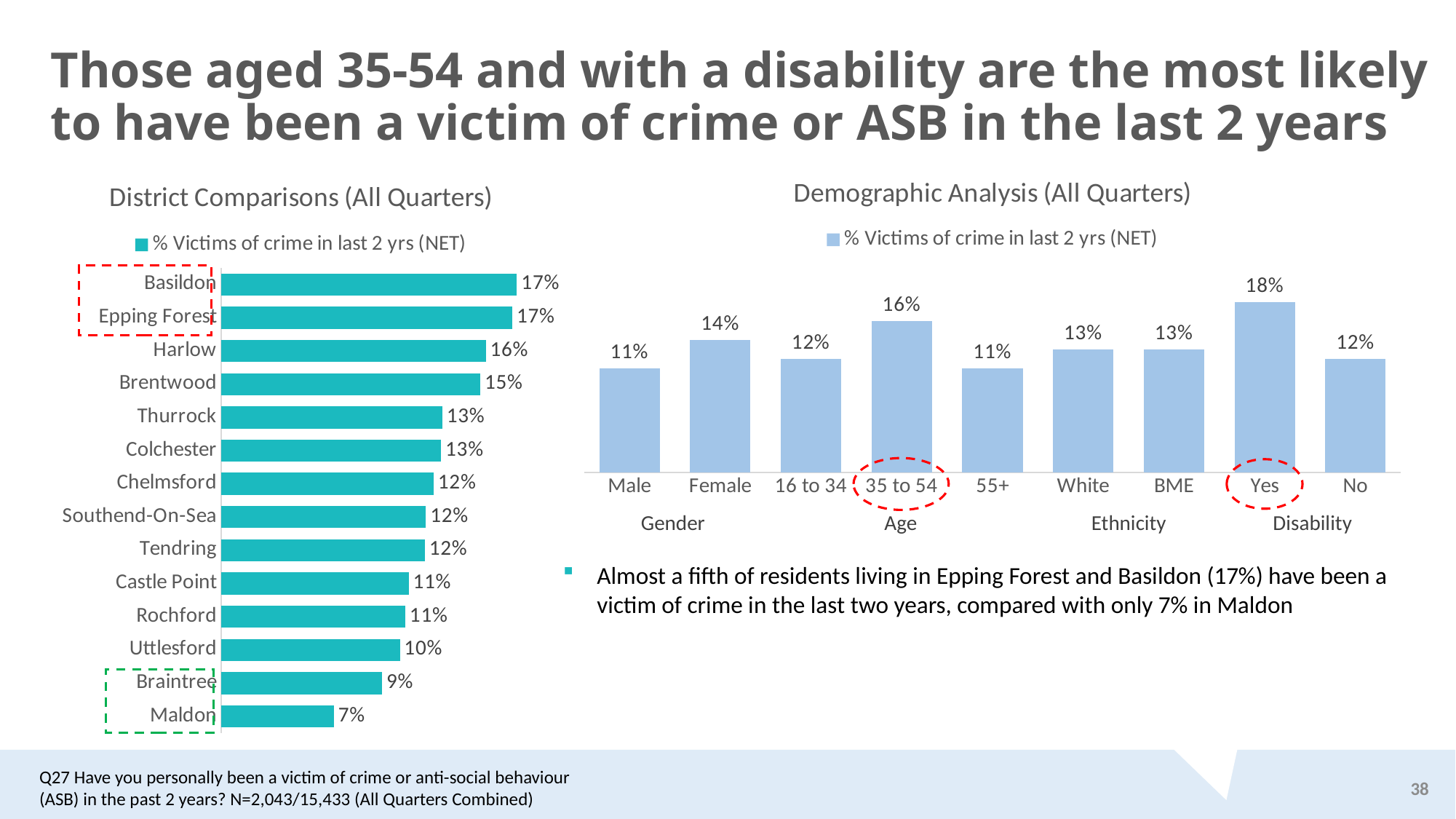
In the Demographic Analysis (All Quarters) chart, what is the value for Female? 14% In the Demographic Analysis (All Quarters) chart, what is the difference between 35 to 54 and 55+? 5 percentage points In the District Comparisons (All Quarters) chart, what is the value for Uttlesford? 10% In the District Comparisons (All Quarters) chart, which district has the lowest value? Maldon In the District Comparisons (All Quarters) chart, what is the difference between Basildon and Maldon? 10 percentage points In the District Comparisons (All Quarters) chart, how many districts are shown? 14 In the Demographic Analysis (All Quarters) chart, which category has the highest value? Yes (Disability) In the District Comparisons (All Quarters) chart, what is the value for Harlow? 16% In the Demographic Analysis (All Quarters) chart, how many categories are plotted? 9 In the District Comparisons (All Quarters) chart, which is larger, Brentwood or Thurrock? Brentwood What type of chart is the Demographic Analysis (All Quarters) chart? Bar chart What is the legend entry shown for the District Comparisons (All Quarters) chart? % Victims of crime in last 2 yrs (NET)